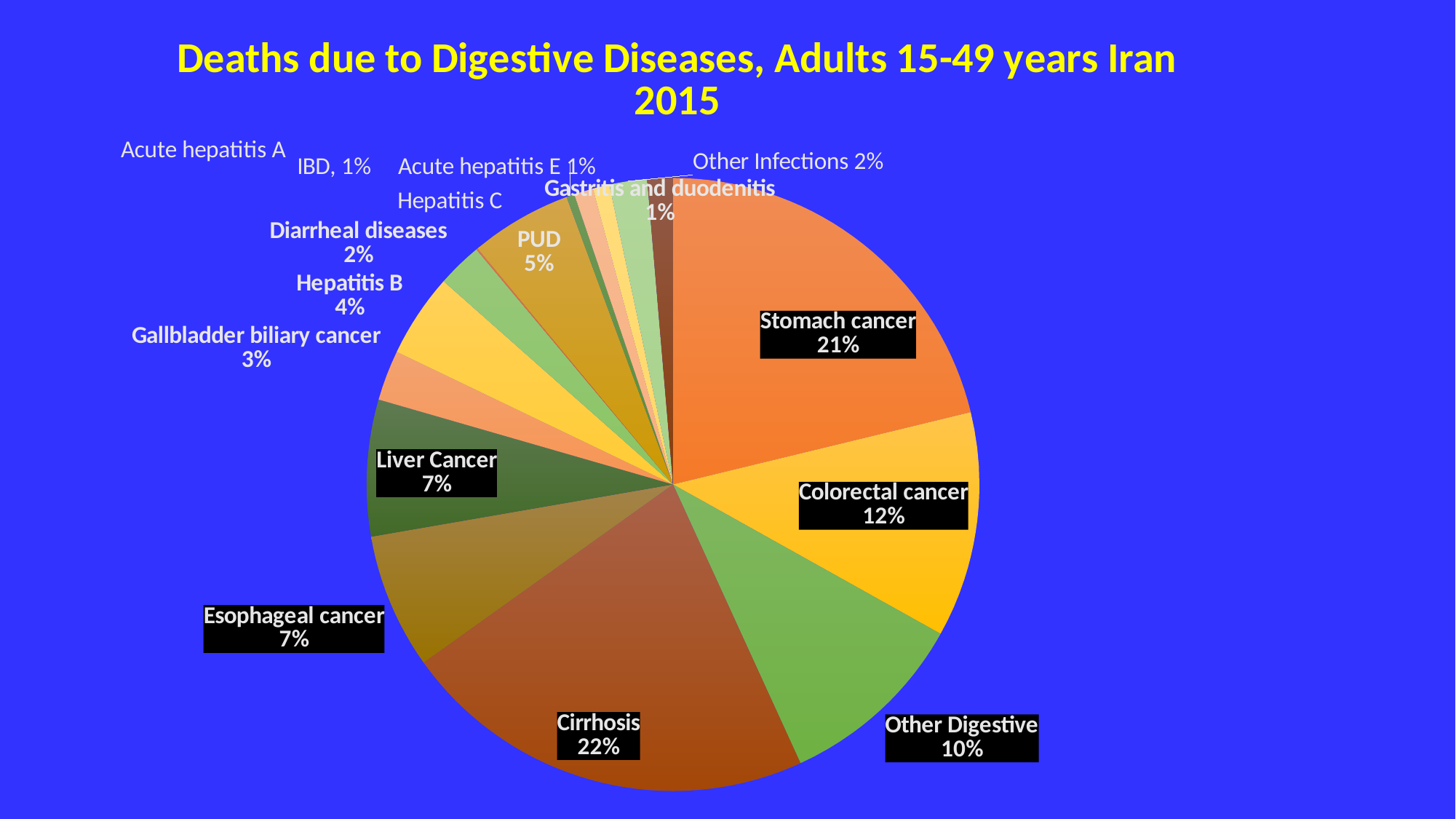
What percentage is shown for Cirrhosis? 22% What percentage is shown for Gallbladder biliary cancer? 3% What percentage is shown for PUD? 5% What share of the pie does Other Digestive represent? 10% What kind of chart is shown on the slide? pie chart What share of deaths is attributed to Stomach cancer? 21% Which is larger, the share for Colorectal cancer or the share for Other Digestive? Colorectal cancer What is the title of the chart? Deaths due to Digestive Diseases, Adults 15-49 years Iran 2015 Which category has the largest share of the pie? Cirrhosis What percentage is shown for Colorectal cancer? 12% What percentage is shown for Hepatitis B? 4% What is the difference in percentage points between Cirrhosis and Stomach cancer? 1 percentage point